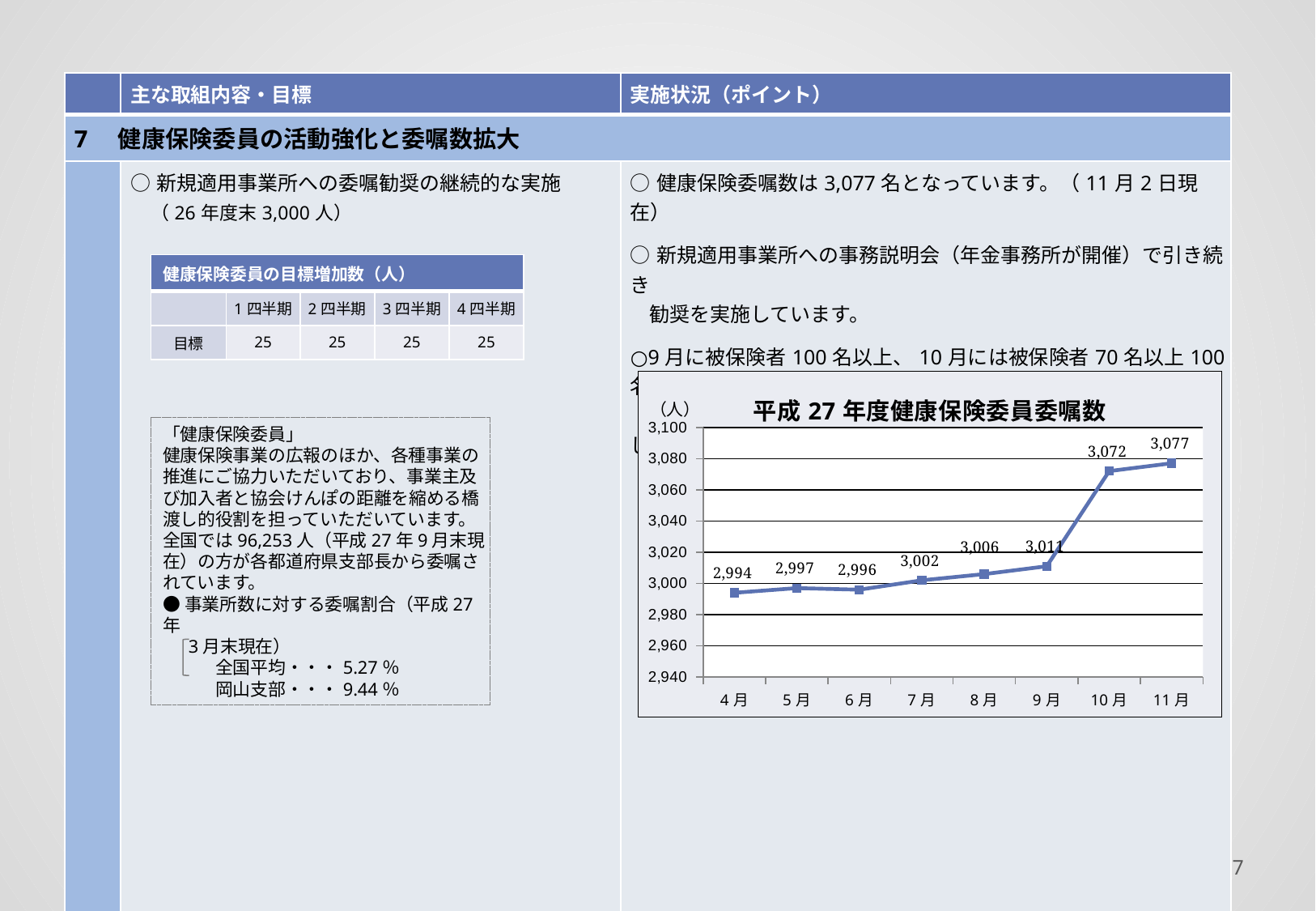
How many months are plotted in the chart 平成27年度健康保険委員委嘱数? 8 What is the value for 4月 in the chart 平成27年度健康保険委員委嘱数? 2,994 What is the value for 7月 in the chart 平成27年度健康保険委員委嘱数? 3,002 Is the value for 9月 in the chart 平成27年度健康保険委員委嘱数 greater or less than 3,000? greater What is the difference between the values for 11月 and 4月 in the chart 平成27年度健康保険委員委嘱数? 83 What is the difference between the values for 10月 and 9月 in the chart 平成27年度健康保険委員委嘱数? 61 Which month has the lowest value in the chart 平成27年度健康保険委員委嘱数? 4月 What is the unit shown at the top of the y axis in the chart 平成27年度健康保険委員委嘱数? (人) In the chart 平成27年度健康保険委員委嘱数, which is larger, the value for 5月 or the value for 6月? 5月 What kind of chart is 平成27年度健康保険委員委嘱数? line chart What is the value for 10月 in the chart 平成27年度健康保険委員委嘱数? 3,072 Which month has the highest value in the chart 平成27年度健康保険委員委嘱数? 11月